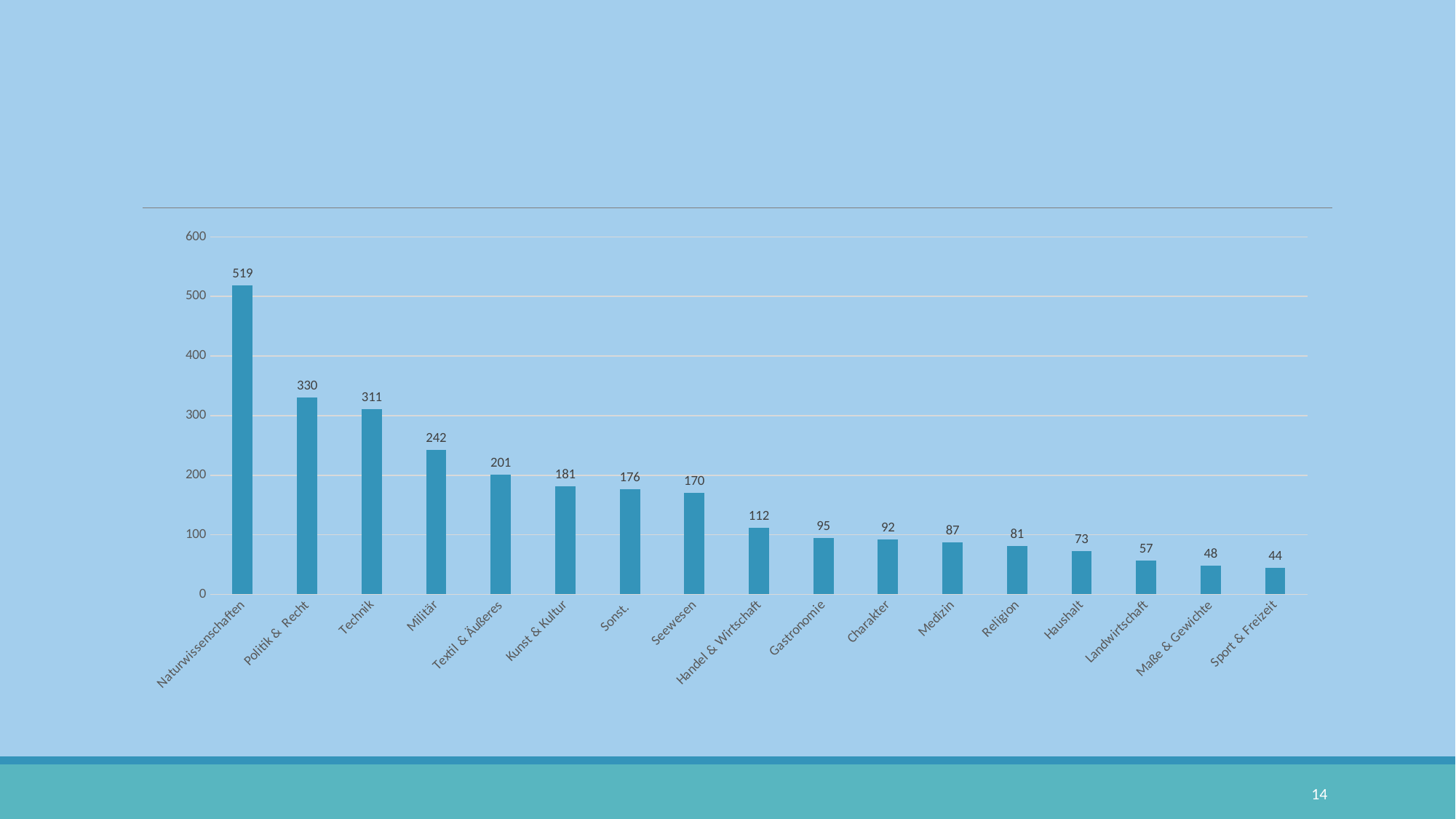
Which category has the highest value? Naturwissenschaften Do the values rise or fall from left to right along the x axis? Fall What is the value for Naturwissenschaften? 519 What is the difference between the values for Politik & Recht and Technik? 19 What kind of chart is shown on the slide? Bar chart Which category has the lowest value? Sport & Freizeit What is the value for Sport & Freizeit? 44 How many categories are shown in the chart? 17 Which is larger, the value for Gastronomie or the value for Charakter? Gastronomie What is the value for Handel & Wirtschaft? 112 What is the value for Militär? 242 Is the value for Textil & Äußeres greater or less than 200? greater